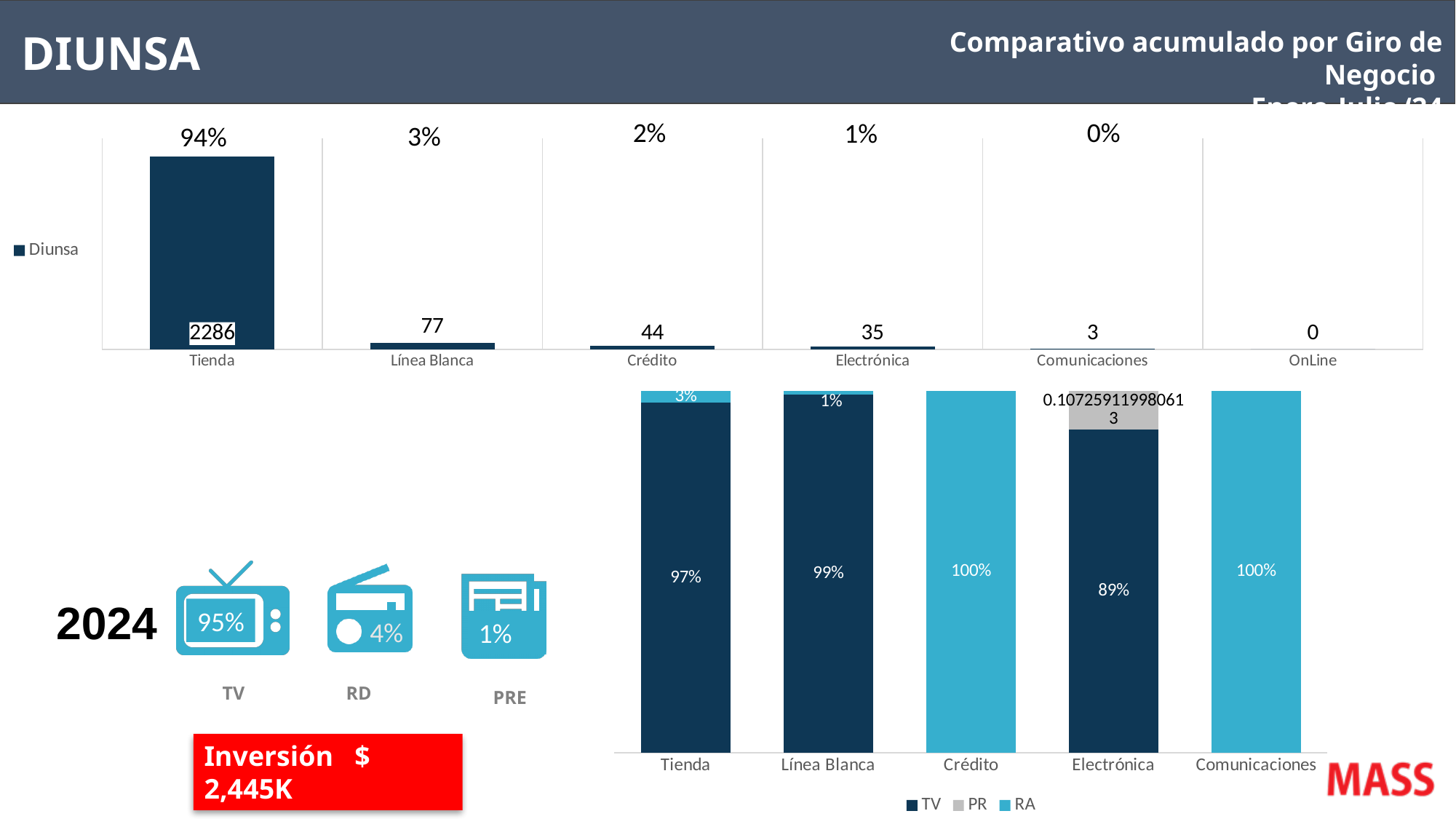
What kind of chart is the bottom chart? Stacked bar chart In the top bar chart, which category has the highest value? Tienda In the top bar chart, how many categories are shown on the x axis? 6 In the top bar chart, what percentage is shown above the Tienda bar? 94% In the bottom stacked bar chart, what is the RA share for Tienda? 3% In the top bar chart, what is the value for Tienda? 2286 In the bottom stacked bar chart, how many series does the legend list? 3 In the top bar chart, what is the difference between the values for Crédito and Electrónica? 9 In the top bar chart, what is the value for Línea Blanca? 77 In the bottom stacked bar chart, what is the TV share for Electrónica? 89% In the top bar chart, which category has the lowest value? OnLine In the top bar chart, what is the value for Electrónica? 35